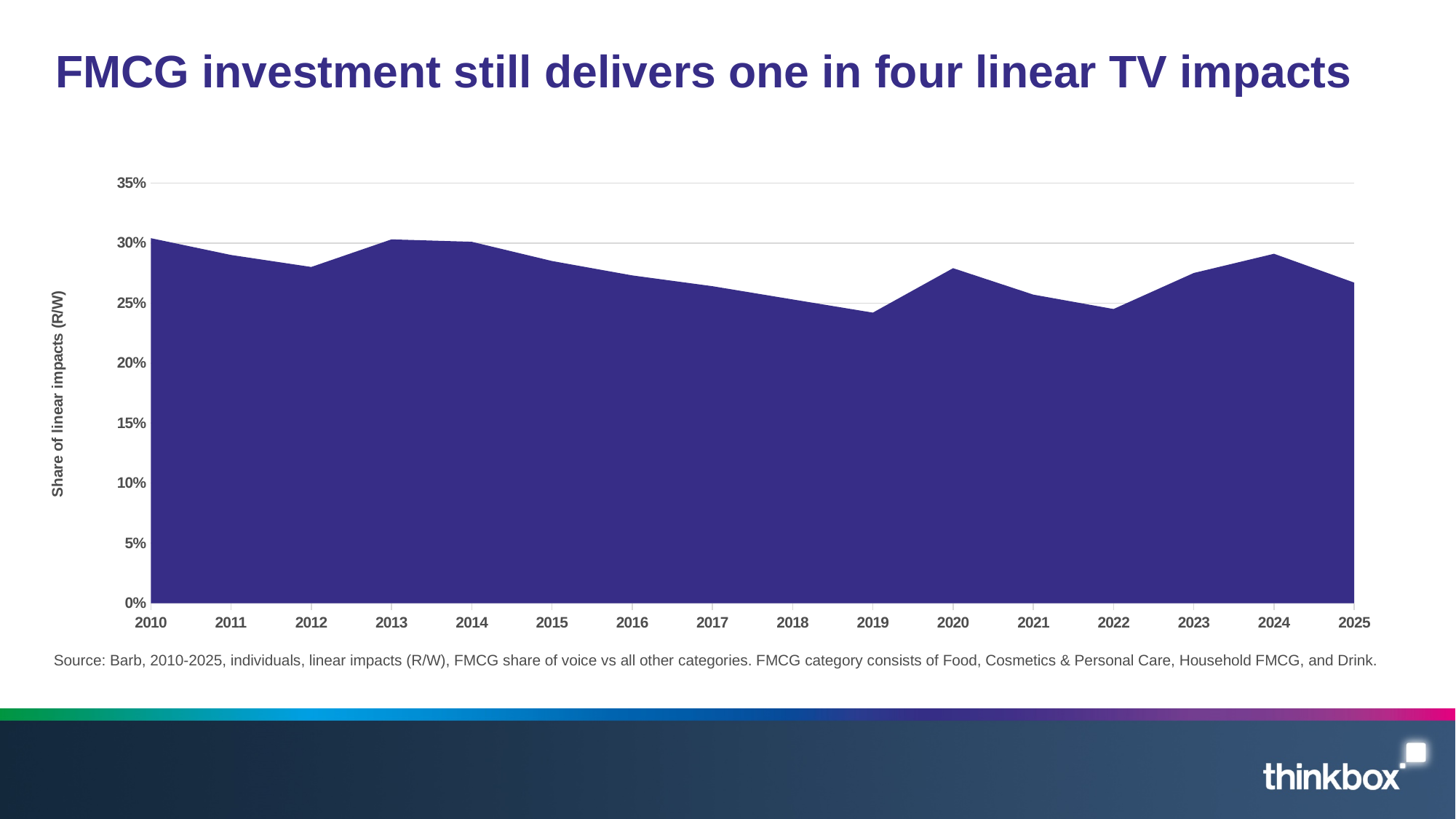
Do the values rise or fall from 2022 to 2024? rise What kind of chart is shown on the slide? Area chart Is the value for 2010 greater or less than 30%? greater Which year has the larger value, 2010 or 2019? 2010 Which year has the larger value, 2020 or 2019? 2020 Do the values rise or fall from 2014 to 2019? fall What is the label on the vertical axis of the chart? Share of linear impacts (R/W) How many years are plotted along the x axis of the chart? 16 Is the value for 2020 greater or less than 25%? greater Is the value for 2016 greater or less than 25%? greater